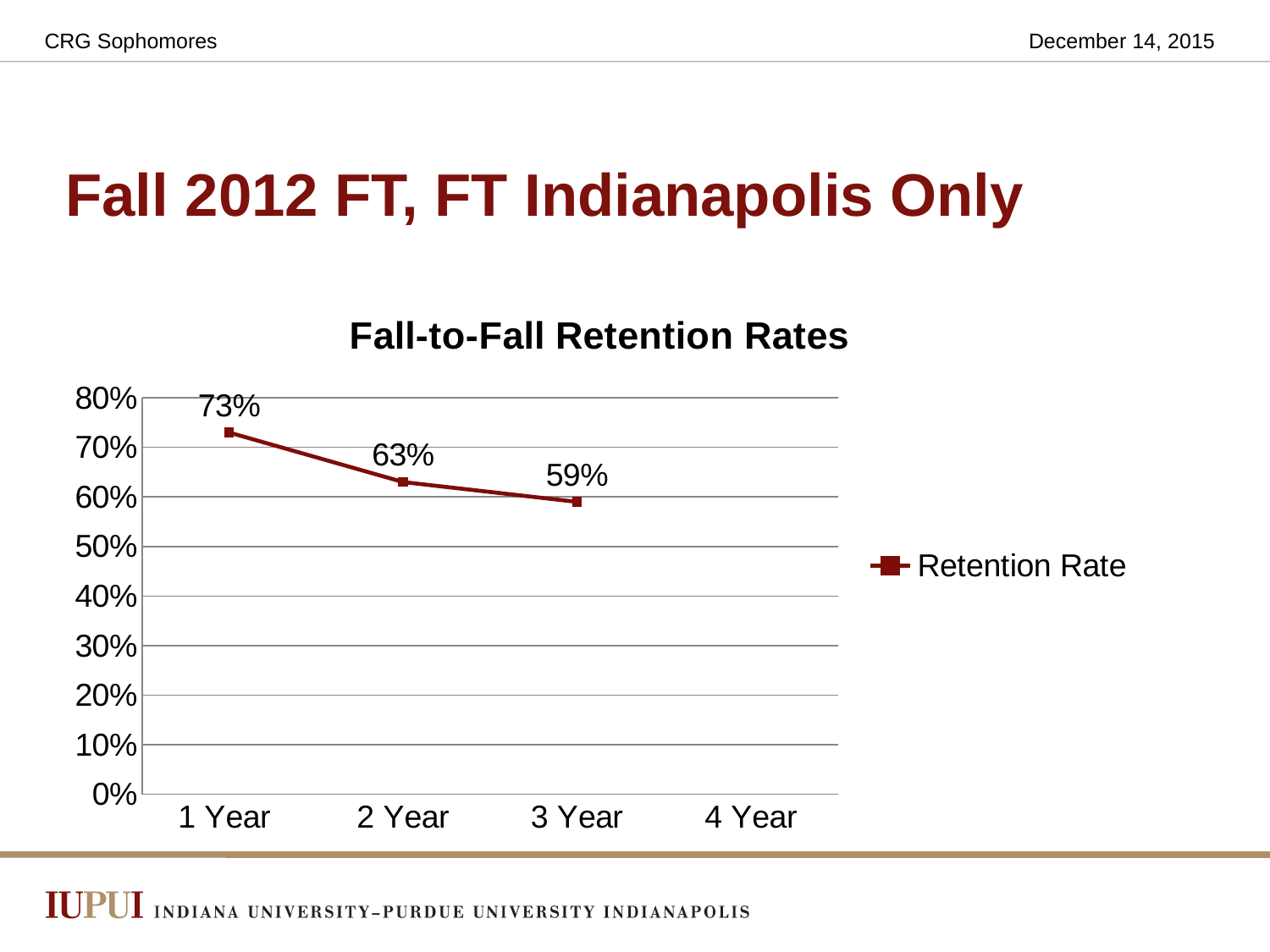
Which year has the highest retention rate? 1 Year What kind of chart is shown? Line chart What is the retention rate at 3 Year? 59% What is the difference between the retention rate at 1 Year and at 2 Year? 10% Which is larger, the retention rate at 2 Year or at 3 Year? 2 Year Does the retention rate rise or fall from 1 Year to 3 Year? Fall What is the retention rate at 1 Year? 73% What is the difference between the retention rate at 1 Year and at 3 Year? 14% What is the retention rate at 2 Year? 63% How many data points are plotted on the line? 3 Is the retention rate at 1 Year greater or less than 70%? greater Which year with a plotted value has the lowest retention rate? 3 Year